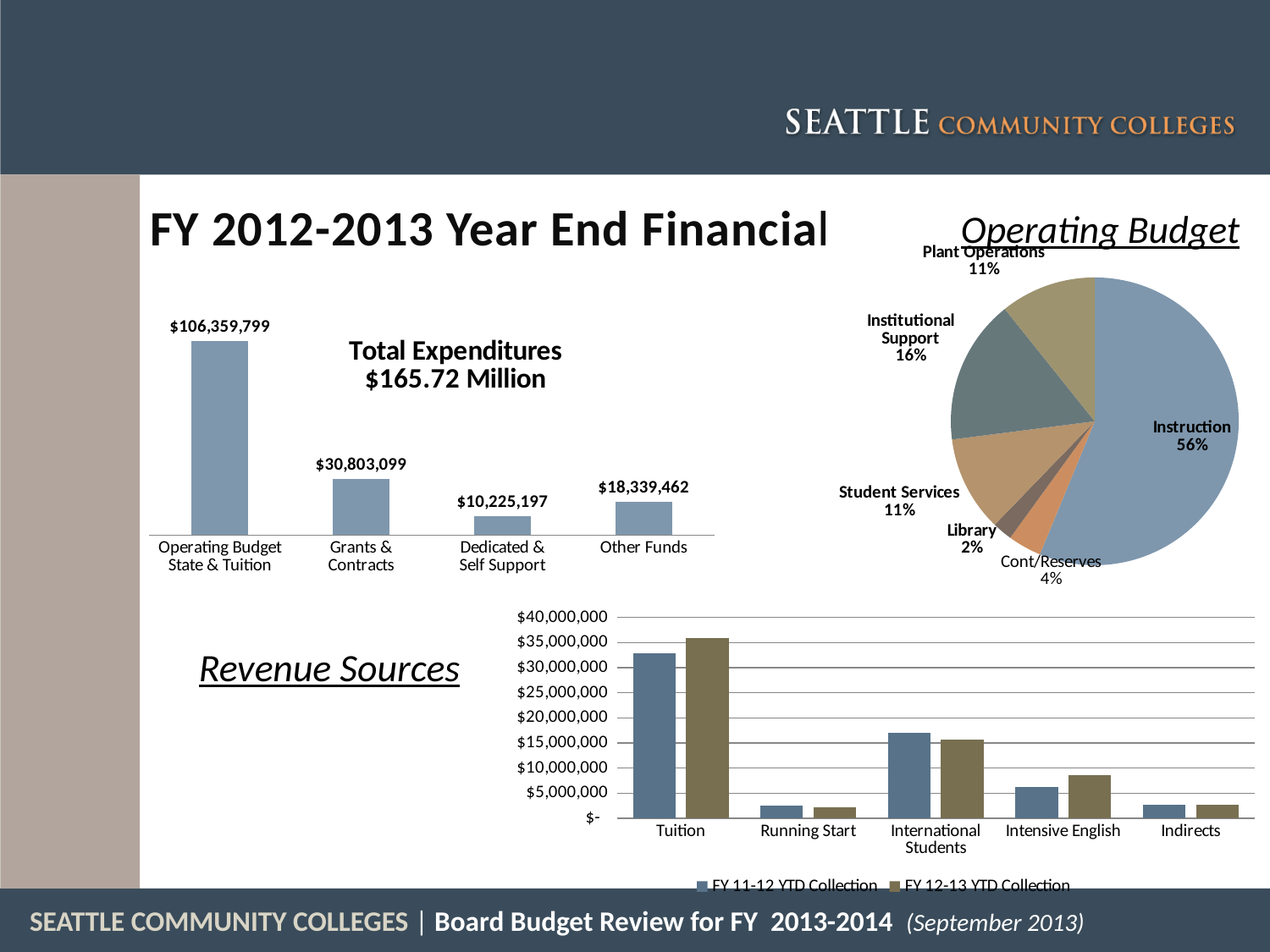
In the Operating Budget pie chart, what share does Instruction have? 56% In the Total Expenditures bar chart, what is the difference between Other Funds and Dedicated & Self Support? $8,114,265 In the Total Expenditures bar chart, what is the value for Grants & Contracts? $30,803,099 What kind of chart is the Revenue Sources chart? Bar chart In the Operating Budget pie chart, what share does Institutional Support have? 16% In the Revenue Sources chart, is the FY 11-12 YTD Collection value for Tuition greater or less than $30,000,000? greater In the Operating Budget pie chart, which slice is the smallest? Library In the Revenue Sources chart, how many series does the legend list? 2 In the Total Expenditures bar chart, how many categories are shown? 4 In the Total Expenditures bar chart, which category has the lowest value? Dedicated & Self Support In the Total Expenditures bar chart, what is the value for Operating Budget State & Tuition? $106,359,799 In the Revenue Sources chart, which is larger for Intensive English: FY 11-12 YTD Collection or FY 12-13 YTD Collection? FY 12-13 YTD Collection